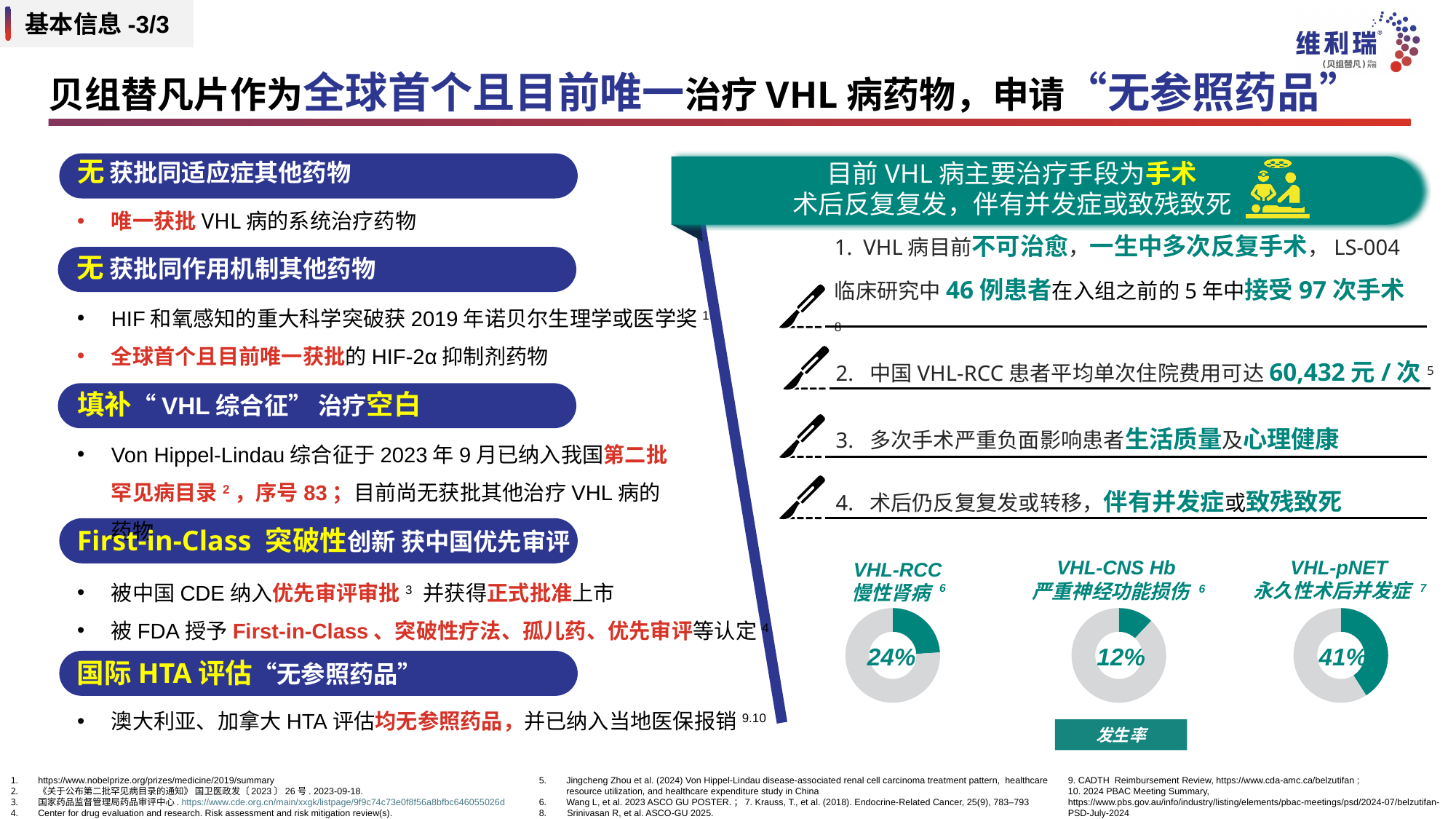
What is the value shown in the VHL-RCC 慢性肾病 donut chart? 24% Among the three donut charts at the bottom right, which condition has the highest incidence rate? VHL-pNET 永久性术后并发症 What is the difference between the VHL-pNET 永久性术后并发症 rate and the VHL-RCC 慢性肾病 rate shown in the donut charts? 17% What is the value shown in the VHL-CNS Hb 严重神经功能损伤 donut chart? 12% What colour is used for the highlighted segment in the three donut charts? Teal green What is the difference between the VHL-RCC 慢性肾病 rate and the VHL-CNS Hb 严重神经功能损伤 rate shown in the donut charts? 12% What label appears in the green box below the three donut charts? 发生率 How many donut charts are shown at the bottom right of the slide? 3 Which is larger: the VHL-RCC 慢性肾病 rate or the VHL-CNS Hb 严重神经功能损伤 rate? VHL-RCC 慢性肾病 What type of chart is used to show the VHL-RCC 慢性肾病 rate? Donut (pie) chart Among the three donut charts at the bottom right, which condition has the lowest incidence rate? VHL-CNS Hb 严重神经功能损伤 What is the value shown in the VHL-pNET 永久性术后并发症 donut chart? 41%